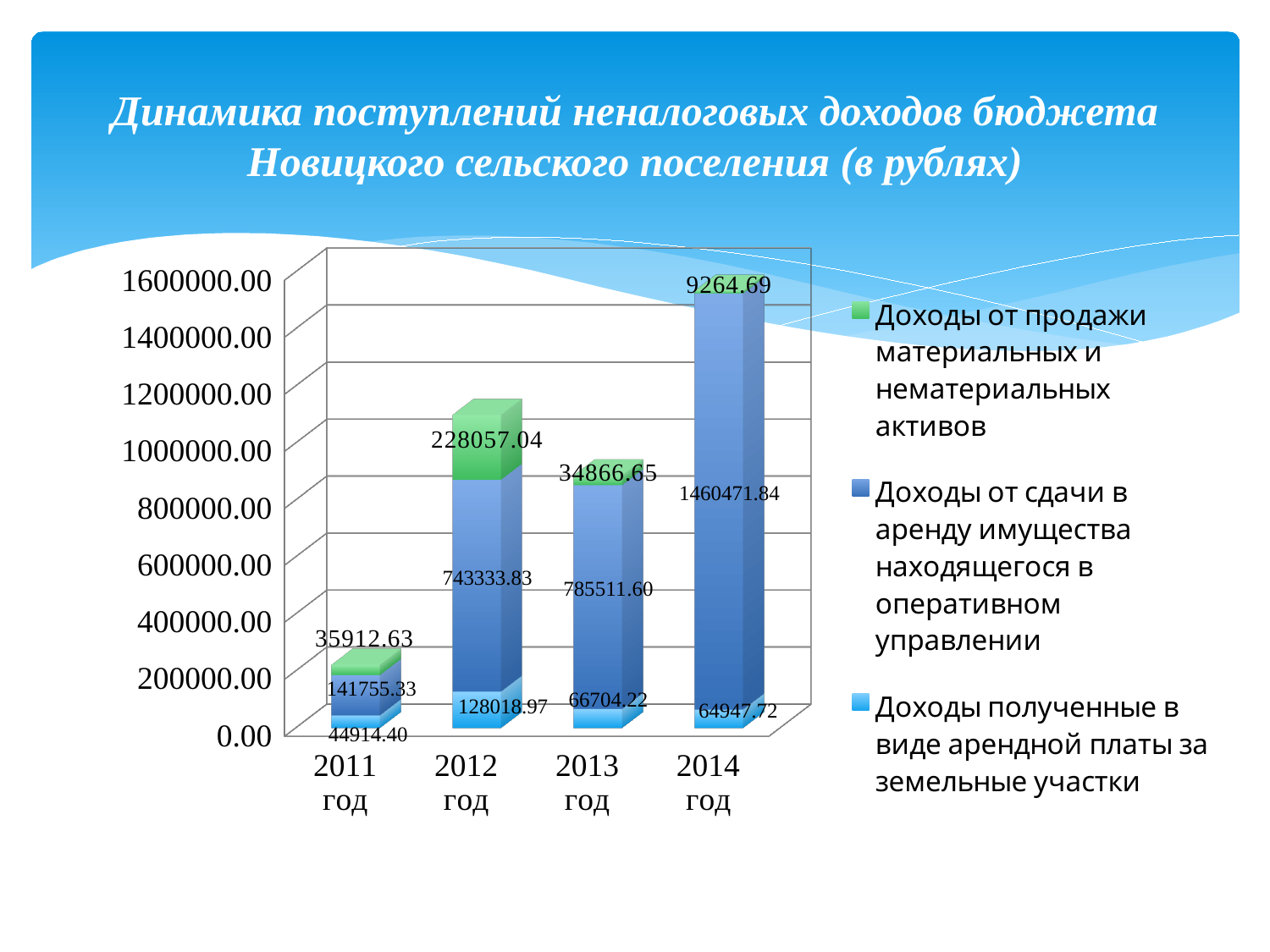
In which year is 'Доходы от сдачи в аренду имущества находящегося в оперативном управлении' the highest? 2014 год What is the value of 'Доходы от сдачи в аренду имущества находящегося в оперативном управлении' for 2014 год? 1460471.84 What is the value of 'Доходы полученные в виде арендной платы за земельные участки' for 2011 год? 44914.40 What is the value of 'Доходы от продажи материальных и нематериальных активов' for 2012 год? 228057.04 Which is larger: 'Доходы полученные в виде арендной платы за земельные участки' in 2012 год or in 2013 год? 2012 год In which year is 'Доходы от продажи материальных и нематериальных активов' the lowest? 2014 год What is the total of the stacked bar for 2013 год? 887082.47 What is the difference between the 2014 and 2013 values of 'Доходы от сдачи в аренду имущества находящегося в оперативном управлении'? 674960.24 Is the total of the stacked bar for 2014 год greater or less than 1400000.00? greater How many series does the legend list? 3 What type of chart is shown on the slide? stacked bar chart How many years (categories) are shown on the x axis? 4